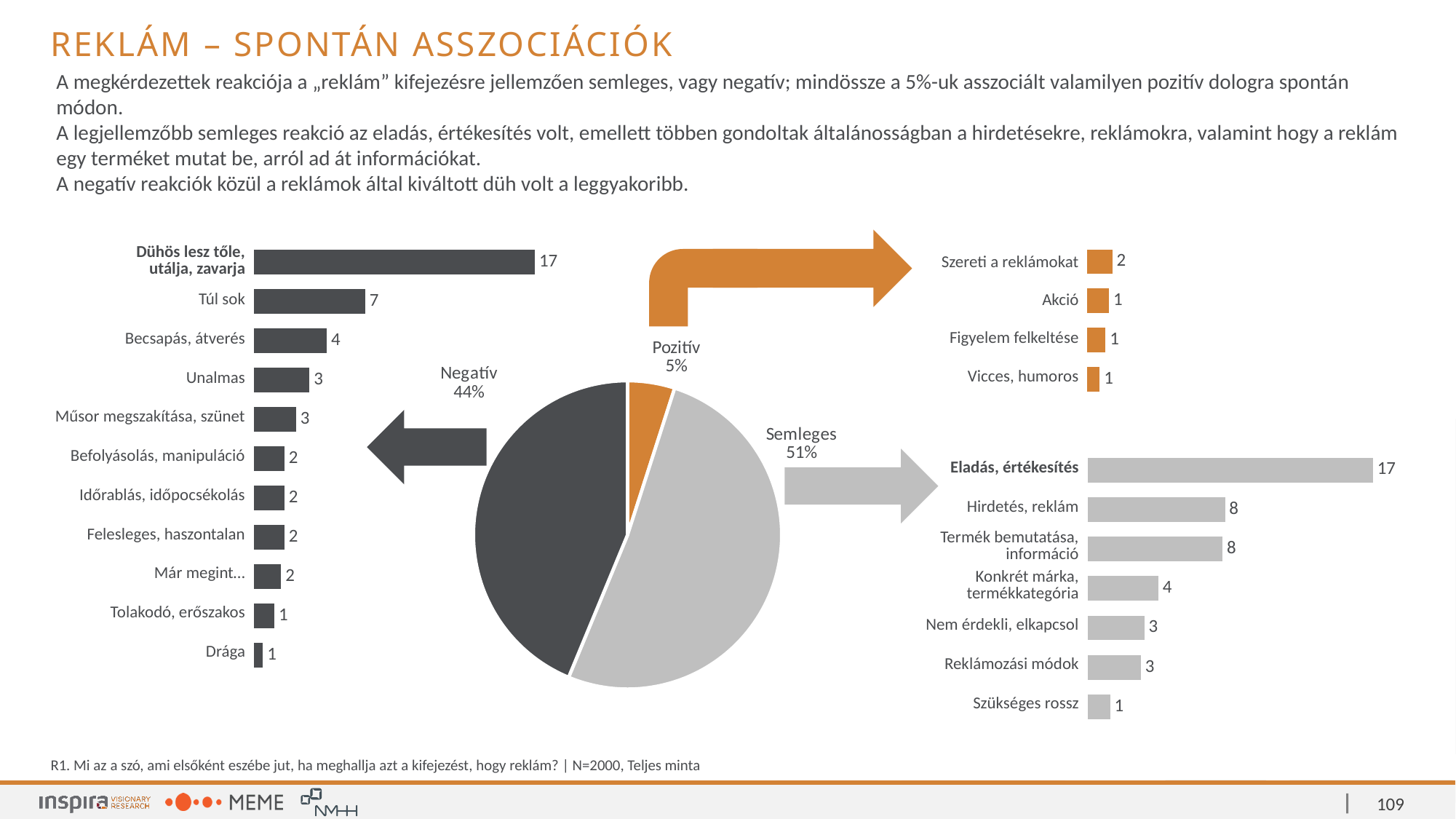
In the pie chart in the centre of the slide, which slice is the smallest? Pozitív In the pie chart in the centre of the slide, how many slices are there? 3 In the bar chart on the left of the slide, what is the difference between the values for "Dühös lesz tőle, utálja, zavarja" and "Túl sok"? 10 In the bar chart at the bottom right of the slide, what is the value for "Hirdetés, reklám"? 8 In the bar chart on the left of the slide, how many categories are shown? 11 What kind of chart is shown in the centre of the slide? Pie chart In the bar chart on the left of the slide, what is the value for "Túl sok"? 7 In the pie chart in the centre of the slide, what share does the "Pozitív" slice have? 5% In the bar chart at the bottom right of the slide, which is larger: "Konkrét márka, termékkategória" or "Nem érdekli, elkapcsol"? Konkrét márka, termékkategória In the pie chart in the centre of the slide, what share does the "Semleges" slice have? 51% In the bar chart at the top right of the slide, what is the value for "Szereti a reklámokat"? 2 In the bar chart on the left of the slide, which category has the highest value? Dühös lesz tőle, utálja, zavarja